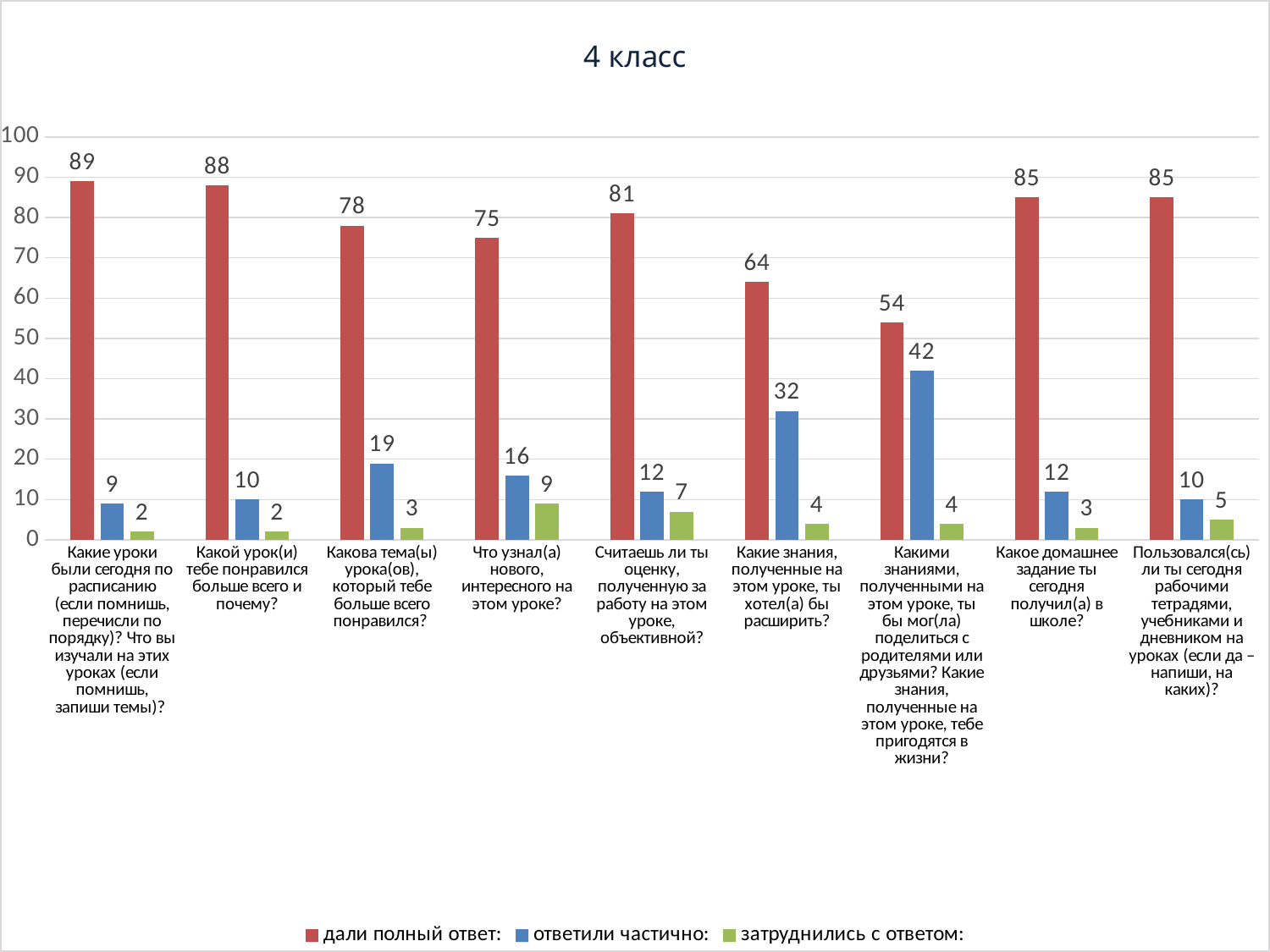
What is the value of "дали полный ответ" for the question "Что узнал(а) нового, интересного на этом уроке?"? 75 What is the title of the chart? 4 класс For which question is the "дали полный ответ" value the highest? Какие уроки были сегодня по расписанию (если помнишь, перечисли по порядку)? Что вы изучали на этих уроках (если помнишь, запиши темы)? What is the value of "затруднились с ответом" for the question "Считаешь ли ты оценку, полученную за работу на этом уроке, объективной?"? 7 For which question is the "дали полный ответ" value the lowest? Какими знаниями, полученными на этом уроке, ты бы мог(ла) поделиться с родителями или друзьями? Какие знания, полученные на этом уроке, тебе пригодятся в жизни? What colour are the bars for the series "затруднились с ответом"? Green Which is larger: the "ответили частично" value for "Какова тема(ы) урока(ов), который тебе больше всего понравился?" or for "Что узнал(а) нового, интересного на этом уроке?"? Какова тема(ы) урока(ов), который тебе больше всего понравился? How many question categories are shown on the x axis? 9 What is the difference between the "дали полный ответ" and "ответили частично" values for the question "Какие знания, полученные на этом уроке, ты хотел(а) бы расширить?"? 32 What type of chart is shown on the slide? Bar chart How many series does the legend list? 3 What is the value of "ответили частично" for the question "Какими знаниями, полученными на этом уроке, ты бы мог(ла) поделиться с родителями или друзьями?"? 42